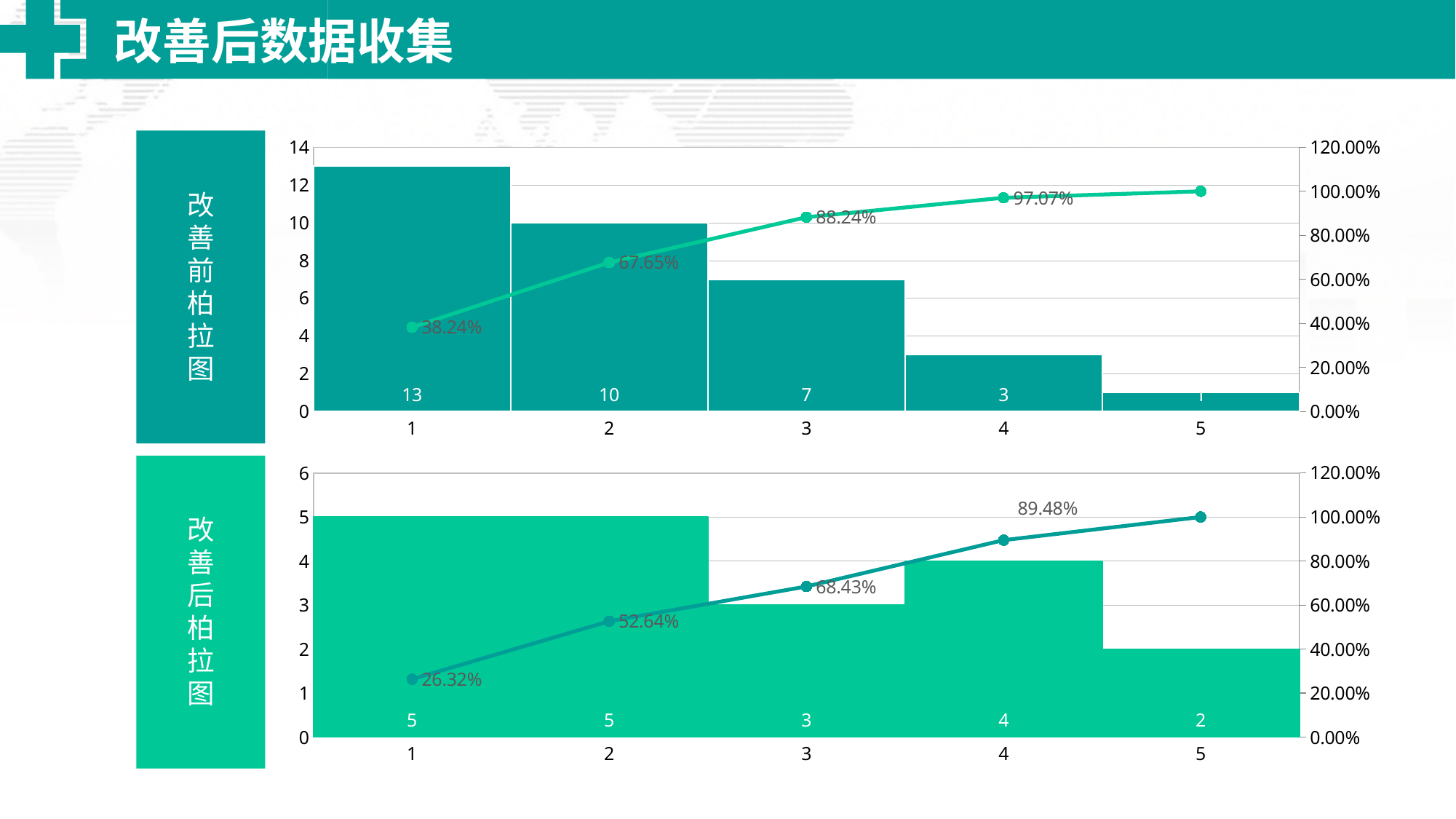
In the bottom chart (改善后柏拉图), which has the larger bar value, category 3 or category 4? 4 In the bottom chart (改善后柏拉图), what is the bar value for category 4? 4 In the top chart (改善前柏拉图), what is the cumulative percentage shown at category 3? 88.24% In the top chart (改善前柏拉图), what is the difference between the bar values for category 1 and category 2? 3 In the top chart (改善前柏拉图), do the bar values rise or fall from category 1 to category 5? fall In the bottom chart (改善后柏拉图), what is the cumulative percentage shown at category 2? 52.64% What kind of chart is the bottom chart (改善后柏拉图)? bar chart with a line In the bottom chart (改善后柏拉图), which category has the lowest bar? 5 In the top chart (改善前柏拉图), what is the bar value for category 1? 13 In the top chart (改善前柏拉图), which category has the highest bar? 1 In the top chart (改善前柏拉图), is the cumulative percentage at category 5 greater or less than 80.00%? greater In the bottom chart (改善后柏拉图), how many categories are shown on the x axis? 5